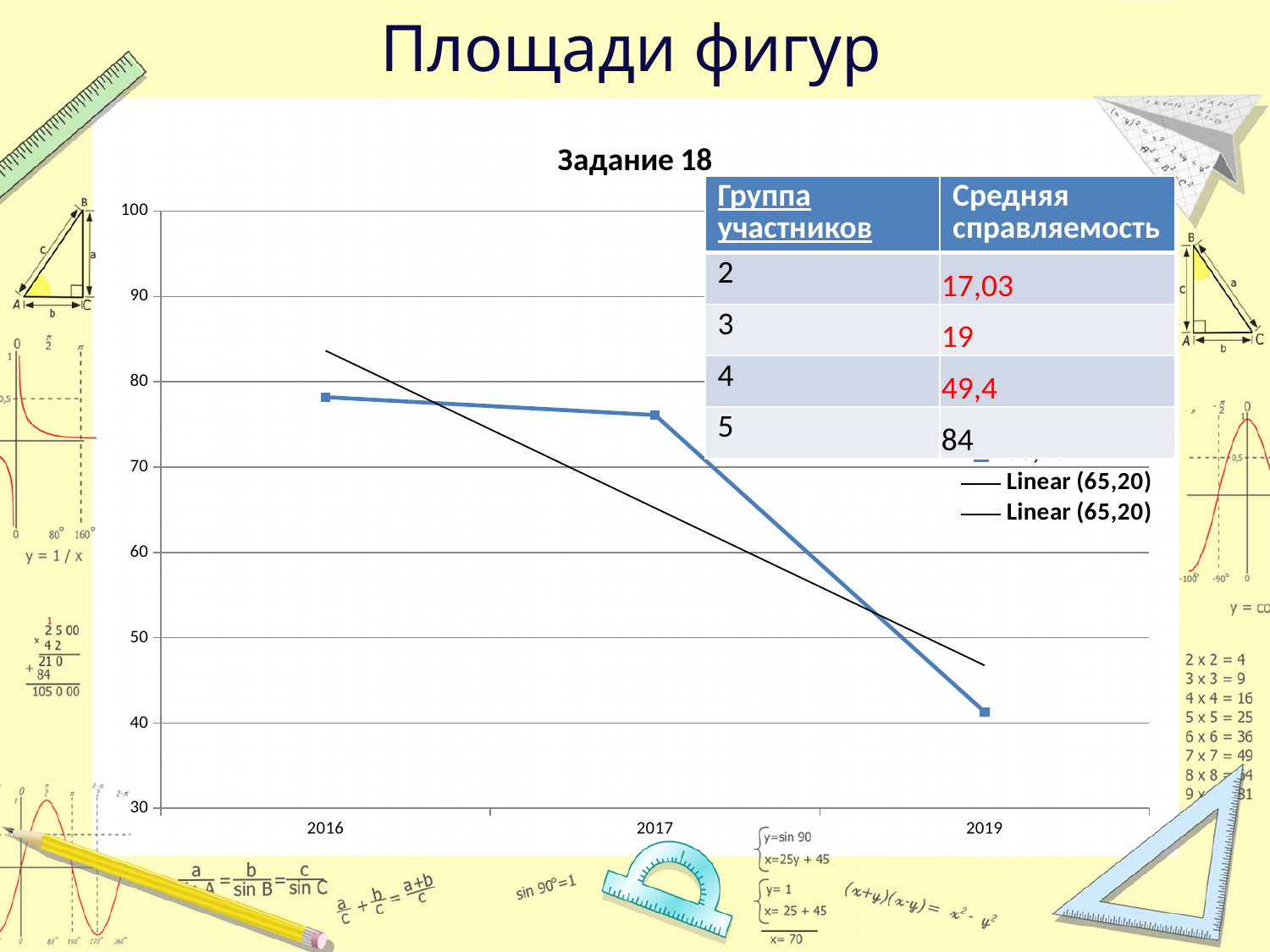
Is the value for 2019 greater or less than 50? less Which year has the lowest value on the blue line? 2019 How many years are plotted along the x axis of the chart? 3 What kind of chart is shown on the slide? line chart Is the value for 2016 greater or less than 80? less What label is given to the black trendline in the legend? Linear (65,20) Is the value for 2017 greater or less than 70? greater Which is larger, the value for 2017 or the value for 2019? 2017 What is the title of the chart? Задание 18 Do the values on the blue line rise or fall from 2016 to 2019? fall